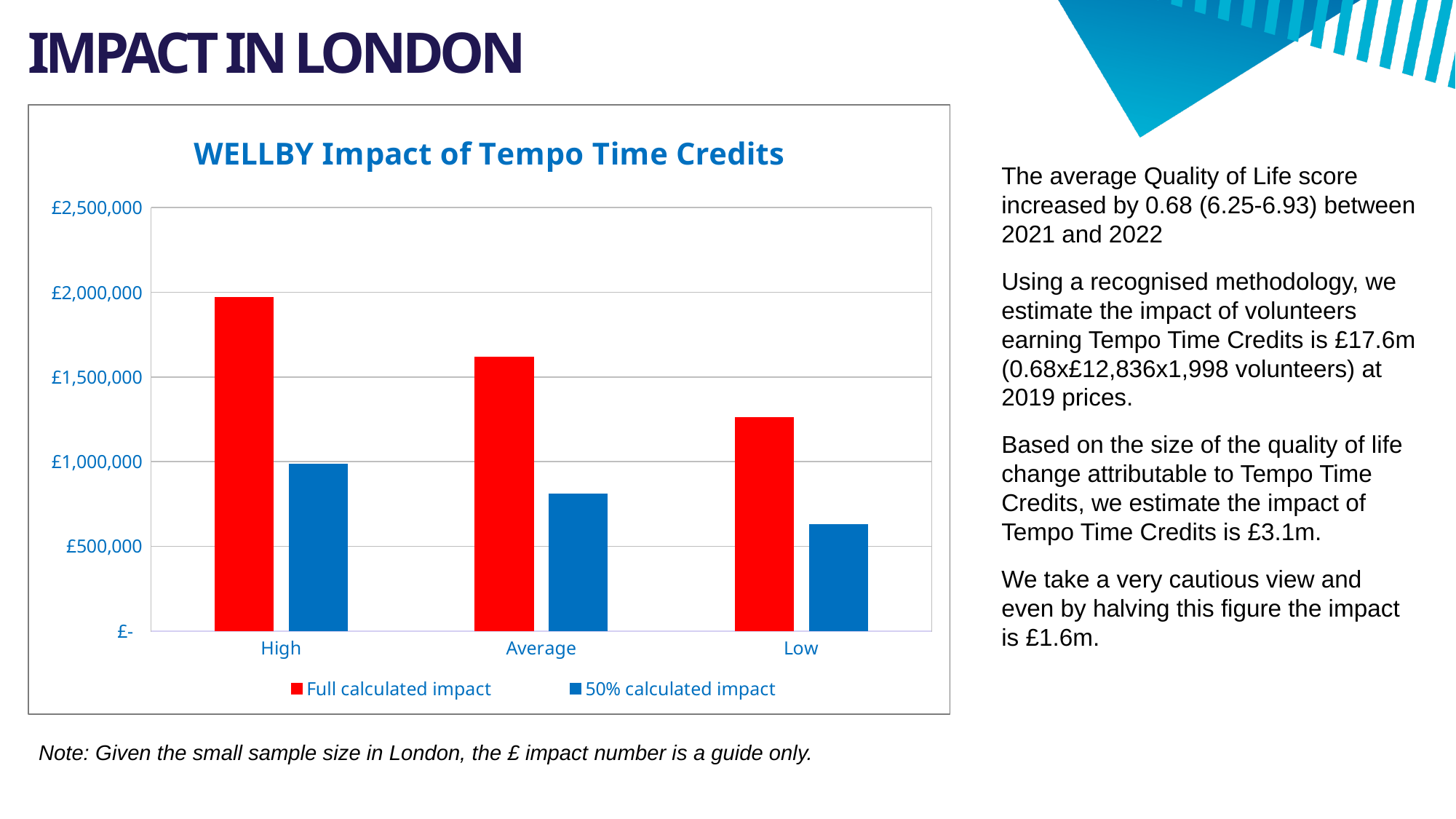
Is the Full calculated impact for Low greater or less than £1,000,000? greater Is the 50% calculated impact for Low greater or less than £500,000? greater Is the 50% calculated impact for Average greater or less than £1,000,000? less Do the Full calculated impact values rise or fall from High to Low along the x axis? fall How many series does the chart's legend list? 2 Which is larger: the Full calculated impact for Average or the Full calculated impact for Low? Full calculated impact for Average How many categories are shown on the x axis of the chart? 3 Which category has the highest Full calculated impact? High Which category has the lowest 50% calculated impact? Low What type of chart is shown on the slide? bar chart What is the title of the chart? WELLBY Impact of Tempo Time Credits